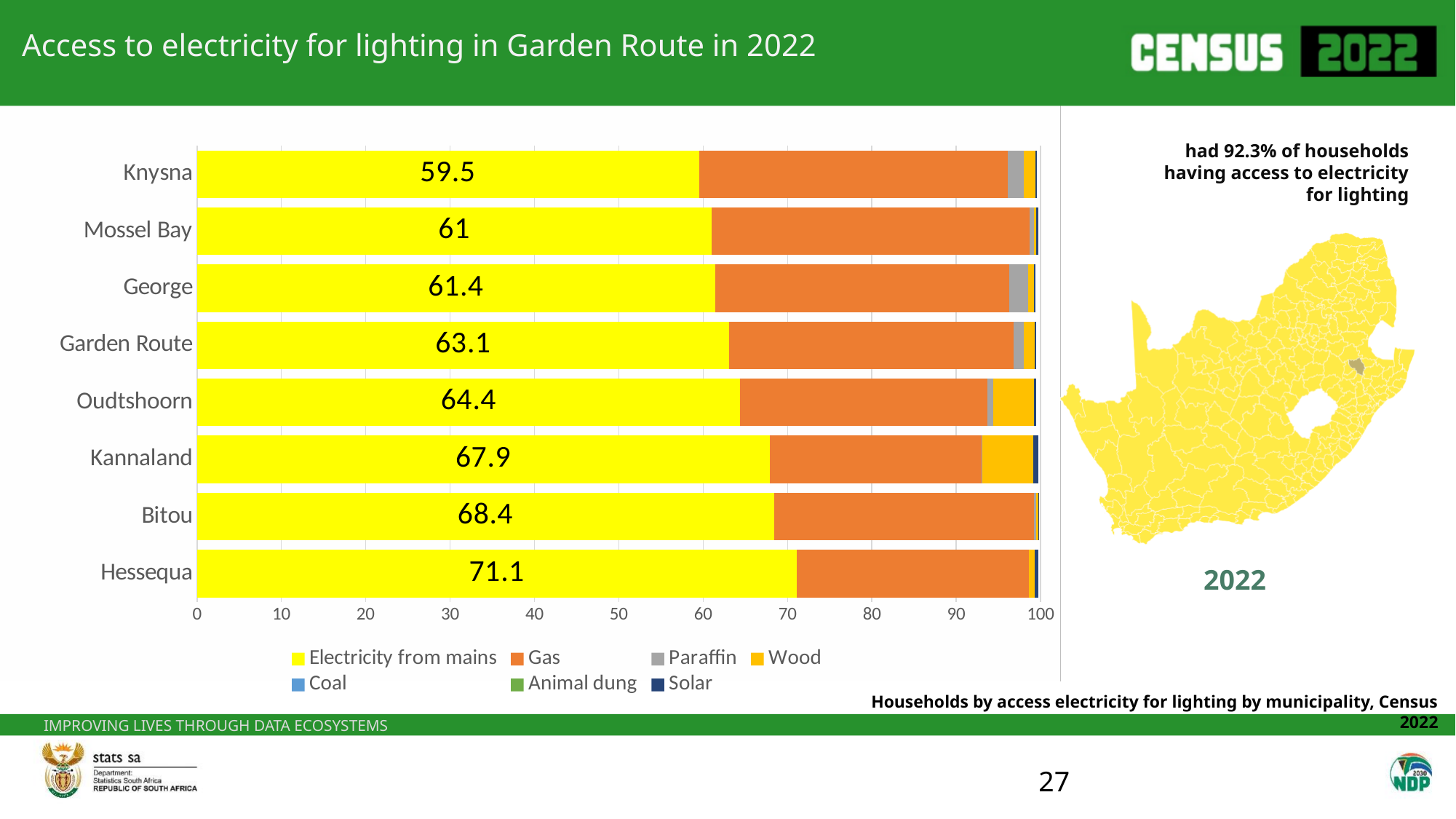
How many municipalities are shown on the chart? 8 Which colour represents Gas in the chart? Orange Which municipality has the highest value for Electricity from mains? Hessequa What is the value for Electricity from mains in Hessequa? 71.1 Which municipality has the lowest value for Electricity from mains? Knysna What is the value for Electricity from mains in Knysna? 59.5 How many series does the legend list? 7 What is the value for Electricity from mains in Garden Route? 63.1 What kind of chart is shown on the slide? Stacked bar chart What is the difference between the Electricity from mains values for Hessequa and Knysna? 11.6 What is the value for Electricity from mains in Oudtshoorn? 64.4 Which has a larger Electricity from mains value, Kannaland or Mossel Bay? Kannaland